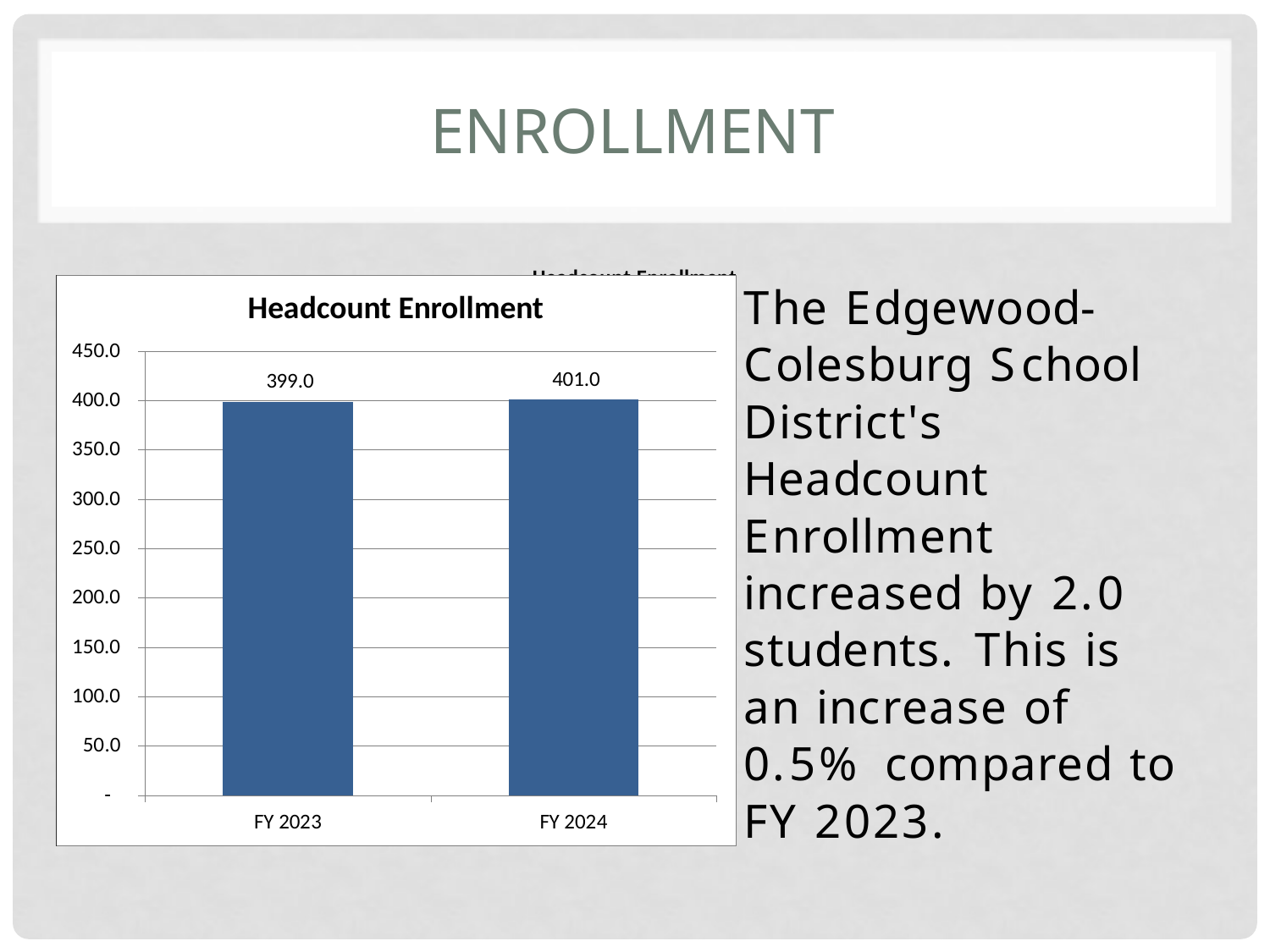
How many fiscal years are shown on the chart? 2 Which fiscal year has the lower Headcount Enrollment? FY 2023 What is the highest value shown on the chart's vertical axis? 450.0 Is the Headcount Enrollment for FY 2024 greater or less than 400.0? greater What is the title of the chart? Headcount Enrollment Which fiscal year has the higher Headcount Enrollment? FY 2024 Does Headcount Enrollment rise or fall from FY 2023 to FY 2024? Rise What kind of chart is used to show Headcount Enrollment? Bar chart What is the difference between the FY 2024 and FY 2023 Headcount Enrollment values? 2.0 What is the Headcount Enrollment value for FY 2024? 401.0 What is the Headcount Enrollment value for FY 2023? 399.0 Is the Headcount Enrollment for FY 2023 greater or less than 400.0? less